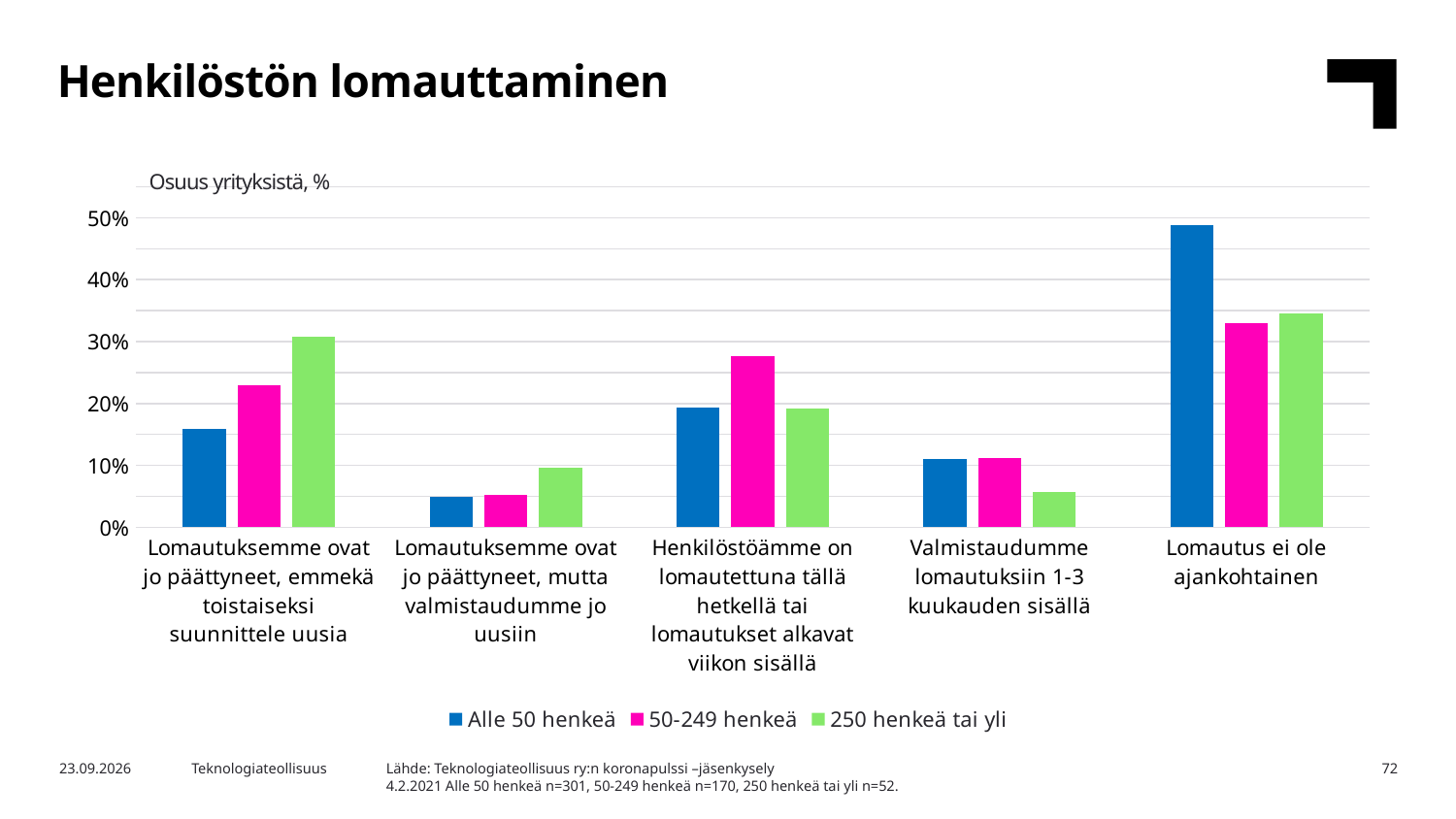
What is the label shown above the vertical axis of the chart? Osuus yrityksistä, % How many series does the legend list? 3 What is the title of the slide? Henkilöstön lomauttaminen What kind of chart is shown on the slide? Bar chart In the category 'Lomautus ei ole ajankohtainen', which series has the highest value? Alle 50 henkeä How many categories are shown on the x axis? 5 Is the value for '250 henkeä tai yli' in the category 'Lomautuksemme ovat jo päättyneet, emmekä toistaiseksi suunnittele uusia' greater or less than 20%? greater Is the value for 'Alle 50 henkeä' in the category 'Lomautus ei ole ajankohtainen' greater or less than 40%? greater In the category 'Henkilöstöämme on lomautettuna tällä hetkellä tai lomautukset alkavat viikon sisällä', which is larger: 'Alle 50 henkeä' or '50-249 henkeä'? 50-249 henkeä Is the value for '50-249 henkeä' in the category 'Lomautuksemme ovat jo päättyneet, mutta valmistaudumme jo uusiin' greater or less than 10%? less For the series 'Alle 50 henkeä', which category has the highest value? Lomautus ei ole ajankohtainen For the series '250 henkeä tai yli', which category has the lowest value? Valmistaudumme lomautuksiin 1-3 kuukauden sisällä